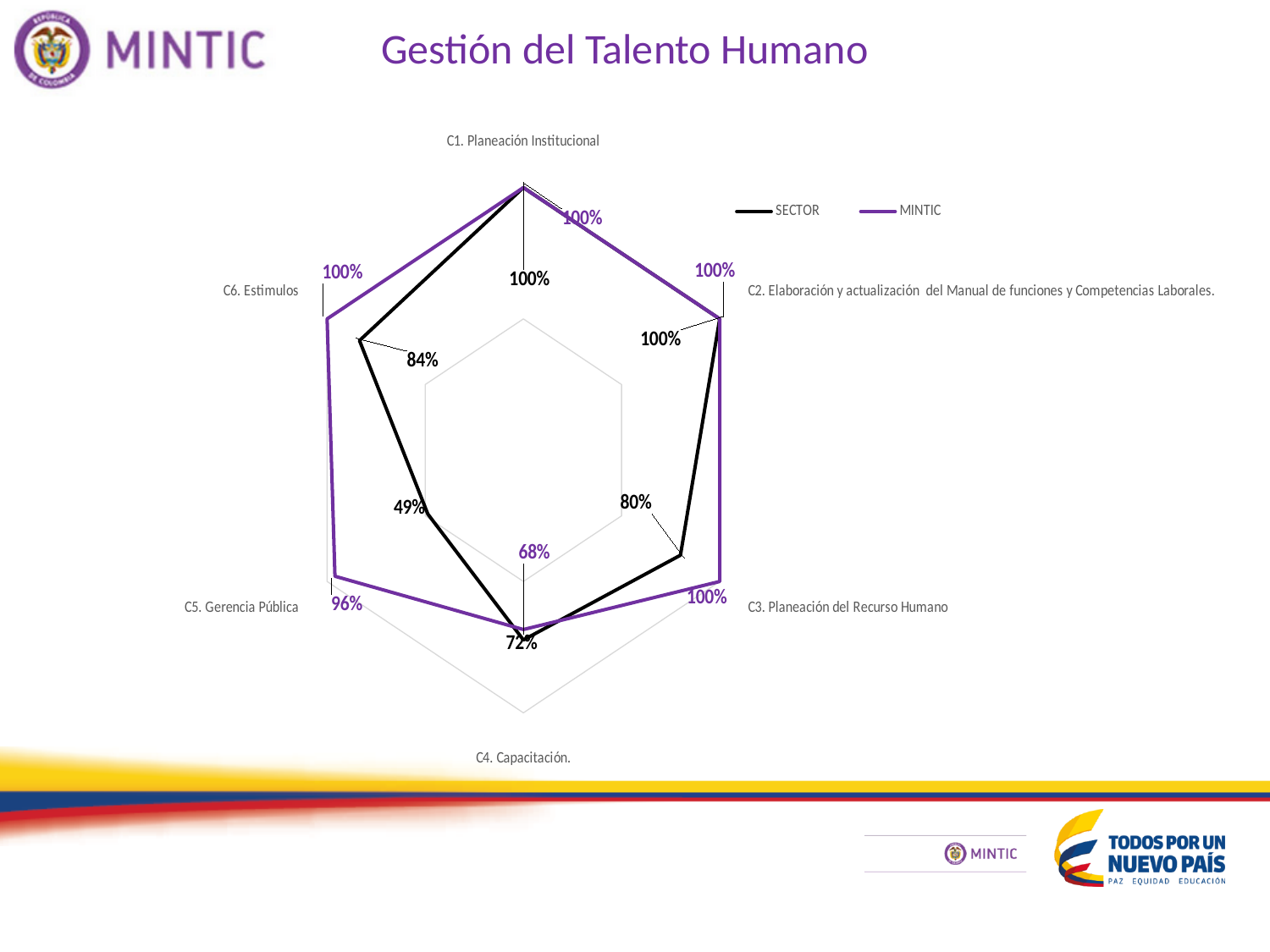
What is the SECTOR value for C6. Estimulos? 84% What is the MINTIC value for C4. Capacitación? 68% What is the SECTOR value for C5. Gerencia Pública? 49% What kind of chart is shown on the slide? Radar chart For C3. Planeación del Recurso Humano, which series has the larger value, SECTOR or MINTIC? MINTIC How many categories (axes) does the radar chart have? 6 How many series does the chart legend list? 2 Which two series are listed in the chart legend? SECTOR and MINTIC What is the MINTIC value for C5. Gerencia Pública? 96% Which category has the lowest SECTOR value? C5. Gerencia Pública What is the difference between the MINTIC and SECTOR values for C5. Gerencia Pública? 47% What is the SECTOR value for C3. Planeación del Recurso Humano? 80%